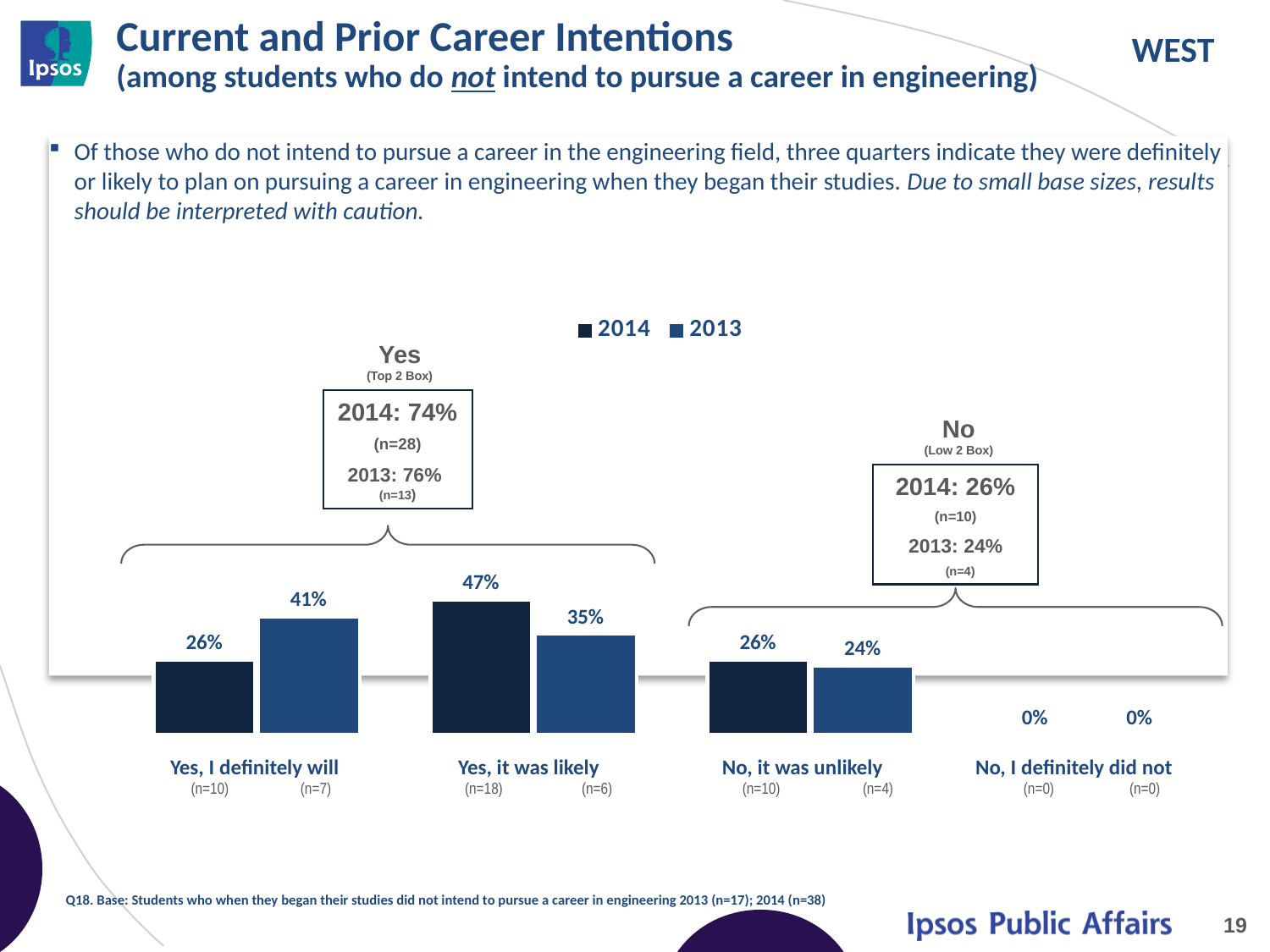
What is the 2013 value for "Yes, I definitely will"? 41% What is the 2014 value for "Yes, it was likely"? 47% Which category has the lowest 2013 value? No, I definitely did not Which category has the highest 2014 value? Yes, it was likely What is the difference between the 2014 and 2013 values for "Yes, it was likely"? 12% For "Yes, I definitely will", which year has the larger value, 2014 or 2013? 2013 What kind of chart is shown on the slide? Bar chart How many series does the legend list? 2 What is the 2014 "Yes (Top 2 Box)" value shown in the callout box? 74% What is the 2013 value for "No, it was unlikely"? 24% What is the difference between the 2013 and 2014 values for "Yes, I definitely will"? 15% How many categories are shown on the x axis? 4